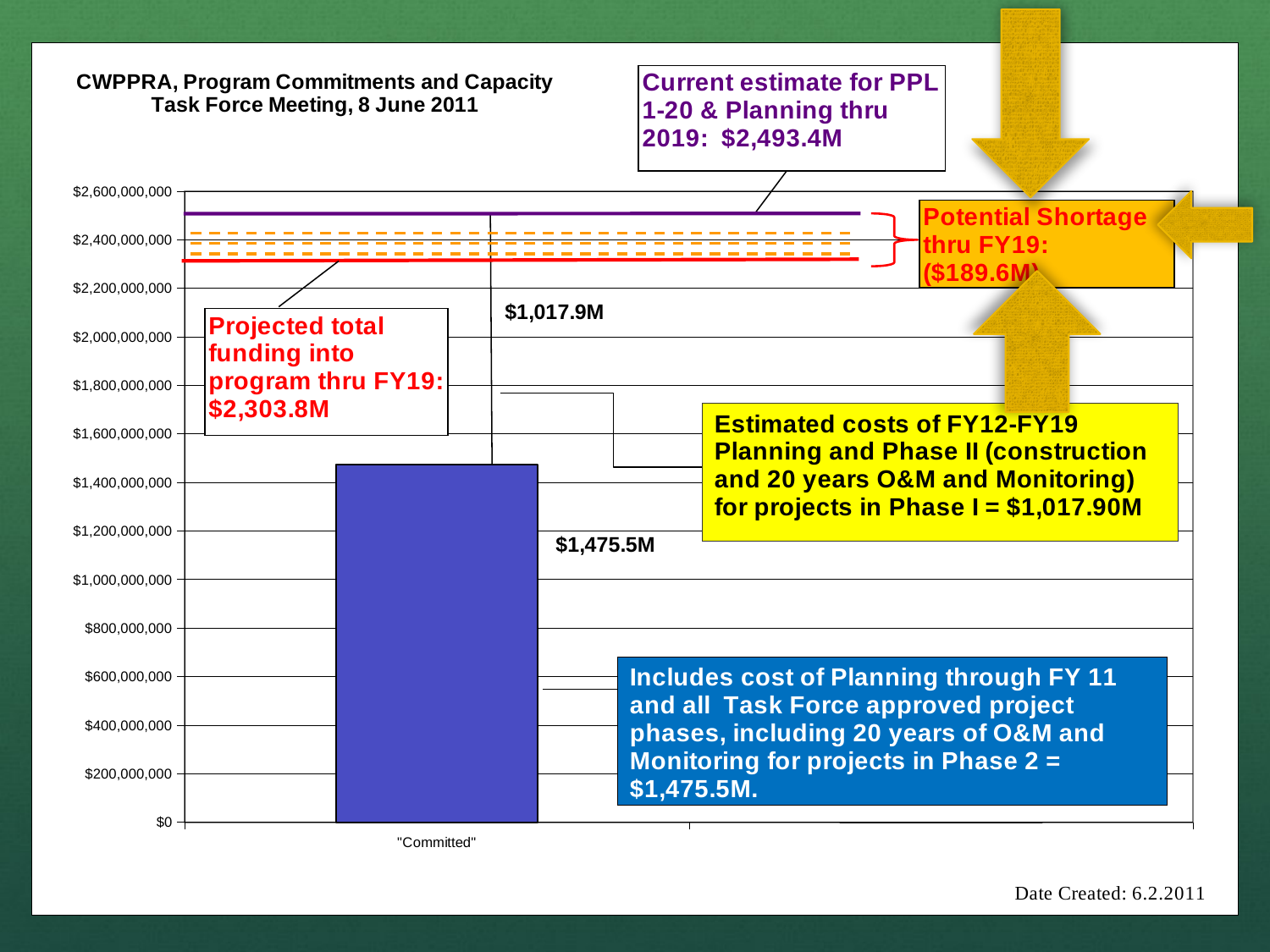
What is the label of the single category on the x axis? "Committed" What value is labelled on the upper segment of the "Committed" bar (estimated costs of FY12-FY19 Planning and Phase II)? $1,017.9M What value is labelled on the blue (lower) segment of the "Committed" bar? $1,475.5M What kind of chart is shown on the slide? bar chart Which is larger: the committed segment ($1,475.5M) or the estimated FY12-FY19 segment ($1,017.9M)? the committed segment ($1,475.5M) What is the current estimate for PPL 1-20 & Planning thru 2019 shown by the purple line? $2,493.4M Is the top of the blue "Committed" segment greater or less than $1,400,000,000 on the y axis? greater What is the highest value shown on the y axis of the chart? $2,600,000,000 How many categories are shown on the x axis of the chart? 1 What is the difference between the current estimate ($2,493.4M) and the projected total funding ($2,303.8M), shown as the potential shortage thru FY19? $189.6M What is the projected total funding into the program thru FY19 shown by the red line? $2,303.8M What is the total of the two stacked segments of the "Committed" bar ($1,475.5M and $1,017.9M)? $2,493.4M